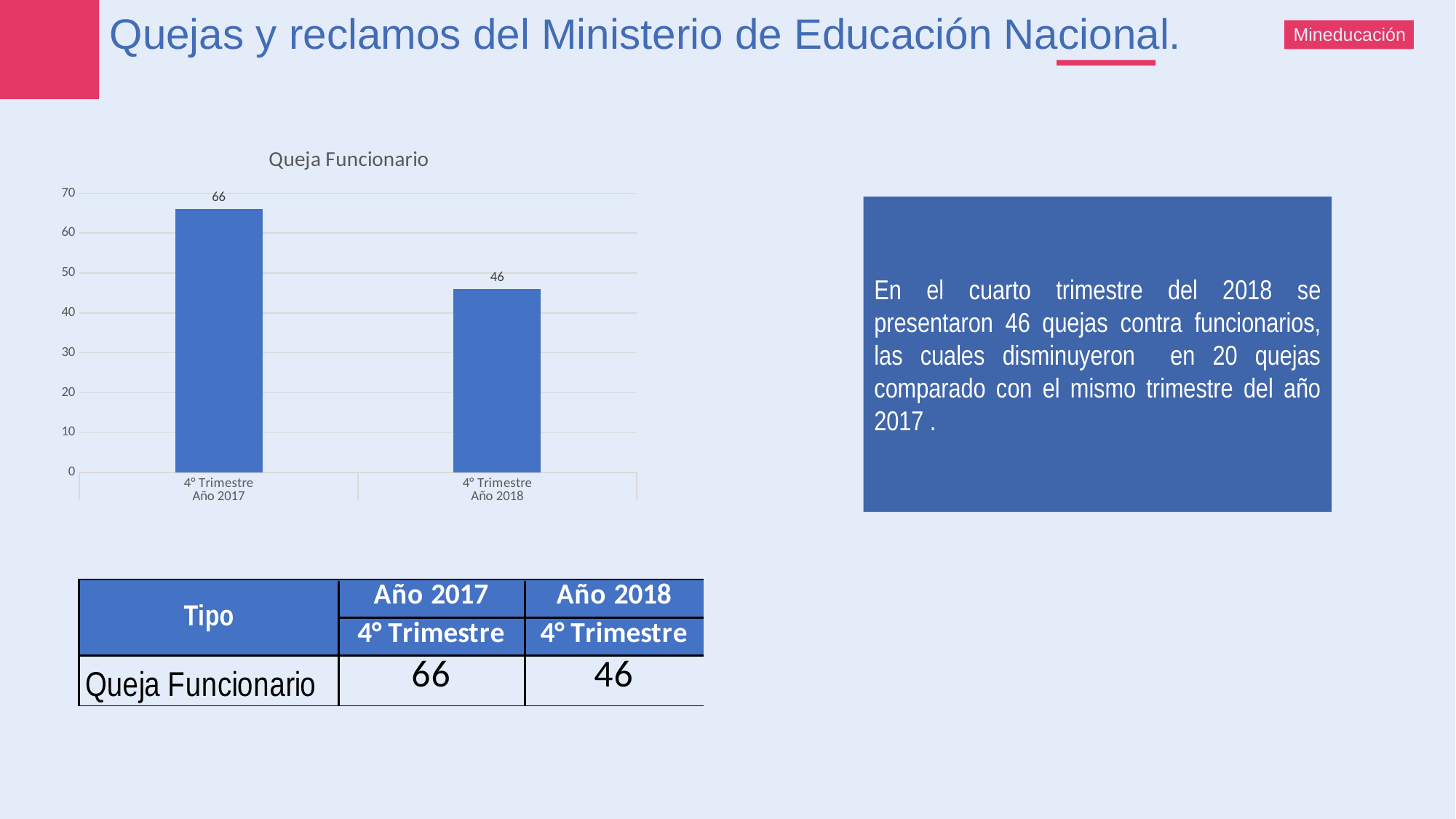
Which category has the lowest value in the Queja Funcionario chart? 4° Trimestre Año 2018 What is the difference between the 4° Trimestre Año 2017 and 4° Trimestre Año 2018 values in the Queja Funcionario chart? 20 What is the title of the chart on the slide? Queja Funcionario How many categories are shown in the Queja Funcionario chart? 2 What is the value for 4° Trimestre Año 2017 in the Queja Funcionario chart? 66 What is the value for 4° Trimestre Año 2018 in the Queja Funcionario chart? 46 Is the value for 4° Trimestre Año 2017 in the Queja Funcionario chart greater or less than 60? greater Do the values in the Queja Funcionario chart rise or fall from 4° Trimestre Año 2017 to 4° Trimestre Año 2018? fall Which category has the highest value in the Queja Funcionario chart? 4° Trimestre Año 2017 Which is larger in the Queja Funcionario chart: the value for 4° Trimestre Año 2017 or 4° Trimestre Año 2018? 4° Trimestre Año 2017 Is the value for 4° Trimestre Año 2018 in the Queja Funcionario chart greater or less than 50? less What kind of chart is the Queja Funcionario chart? bar chart